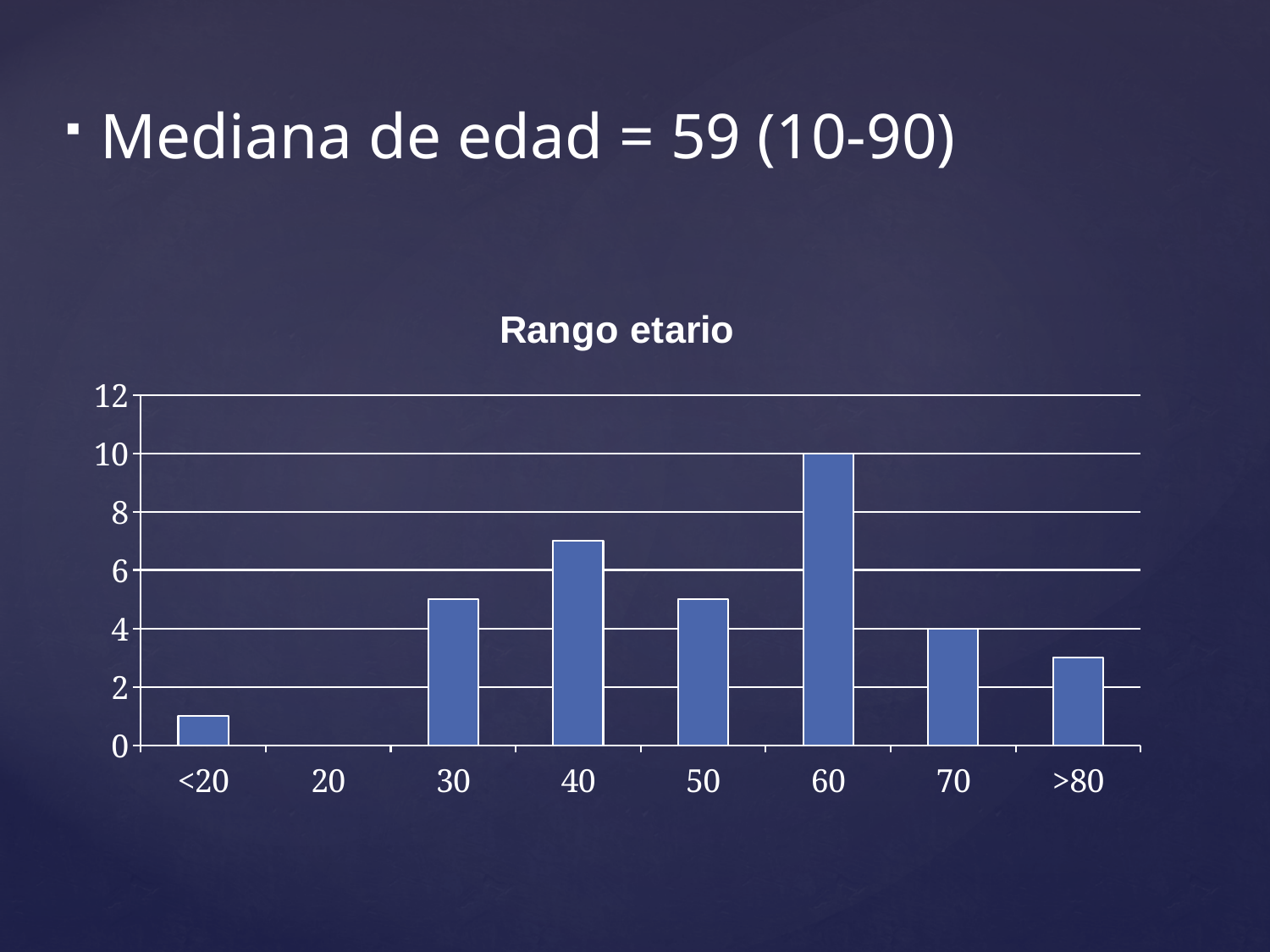
Which age range has the highest value? 60 Is the value for the >80 age range greater or less than 4? less Do the values rise or fall from the 60 age range to the >80 age range? fall What is the value for the 70 age range? 4 What is the difference between the values for the 60 and 70 age ranges? 6 What kind of chart is shown on the slide? bar chart Is the value for the 40 age range greater or less than 6? greater What is the value for the 60 age range? 10 How many age-range categories are shown on the x axis? 8 Is the value for the <20 age range greater or less than 2? less Which has the larger value, the 40 age range or the 50 age range? 40 What is the title of the chart? Rango etario